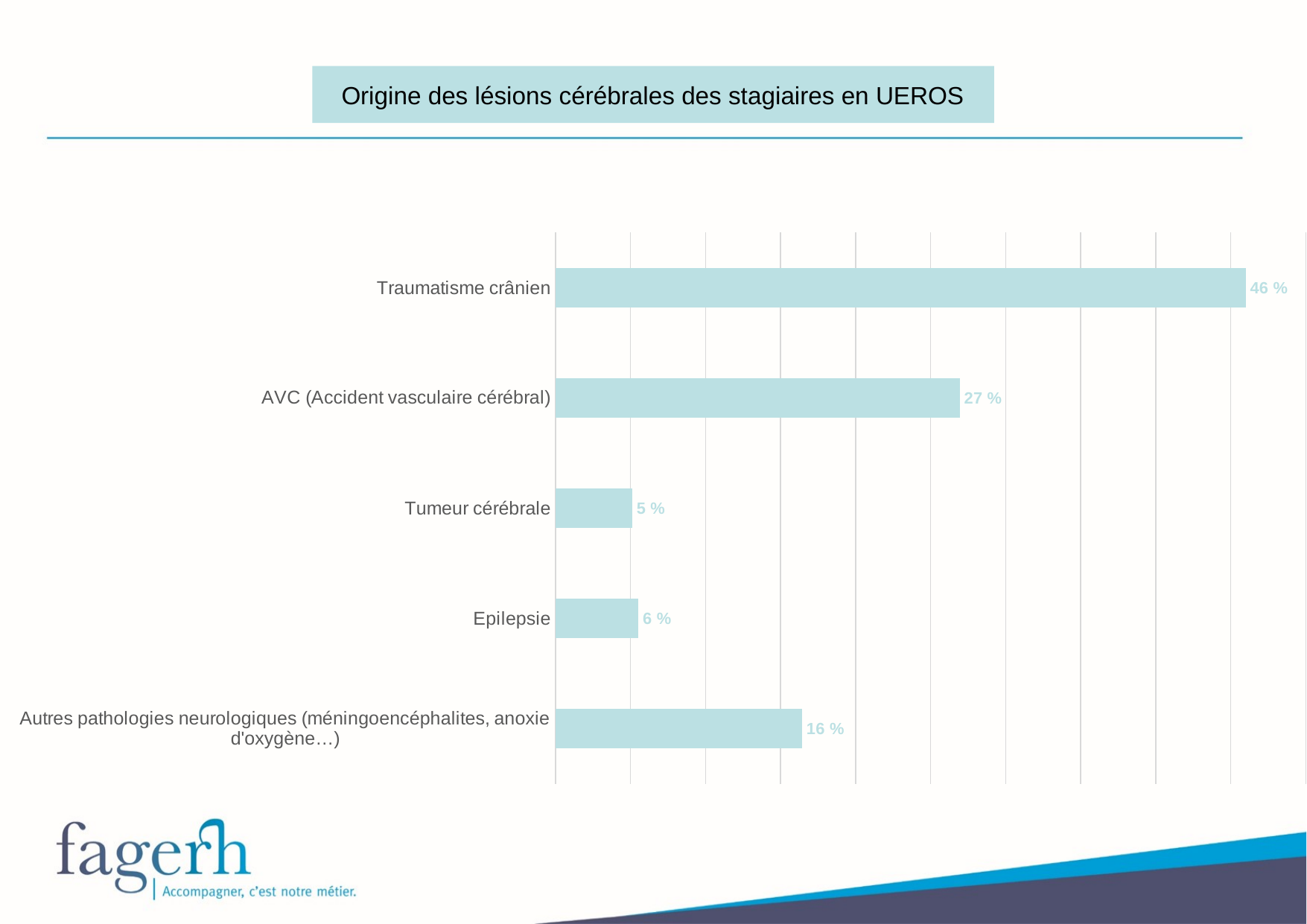
How many categories are shown in the chart? 5 What is the value for Tumeur cérébrale? 5 % What is the difference between the values for Traumatisme crânien and AVC (Accident vasculaire cérébral)? 19 % What is the value for AVC (Accident vasculaire cérébral)? 27 % What kind of chart is shown on the slide? Bar chart What is the title of the slide? Origine des lésions cérébrales des stagiaires en UEROS Which category has the lowest value? Tumeur cérébrale What is the value for Autres pathologies neurologiques (méningoencéphalites, anoxie d'oxygène…)? 16 % What is the value for Epilepsie? 6 % Which category has the highest value? Traumatisme crânien What is the value for Traumatisme crânien? 46 % Which is larger, the value for Epilepsie or the value for Tumeur cérébrale? Epilepsie